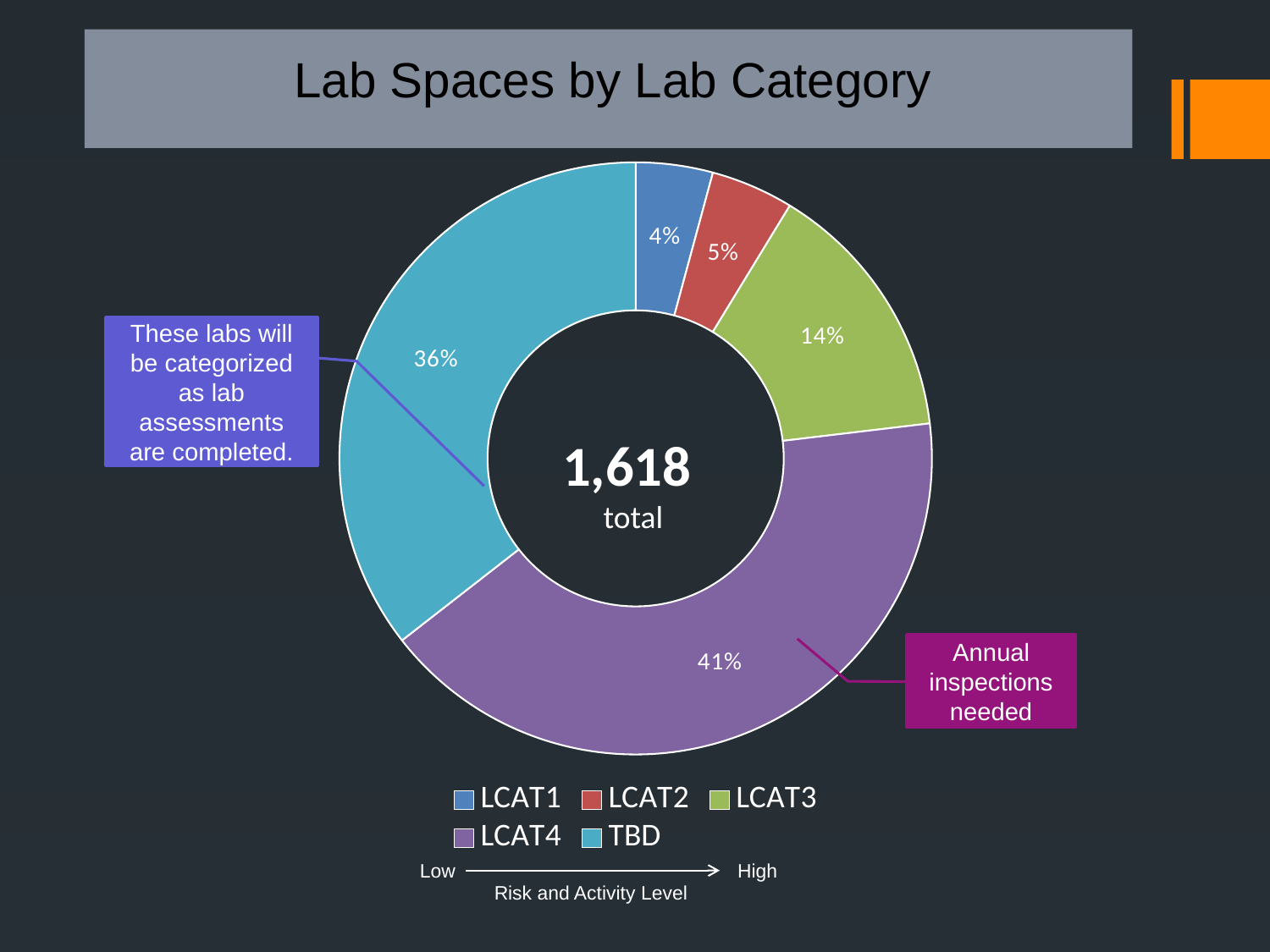
Which category has the smallest share of lab spaces? LCAT1 What share of lab spaces is TBD? 36% What share of lab spaces is LCAT2? 5% What is the difference in percentage points between the LCAT4 and TBD shares? 5 Which category has the largest share of lab spaces? LCAT4 What share of lab spaces is LCAT4? 41% What kind of chart is shown on the slide? Doughnut (pie) chart What total number of lab spaces is shown in the centre of the chart? 1,618 How many categories does the legend list? 5 Which has a larger share, LCAT3 or LCAT2? LCAT3